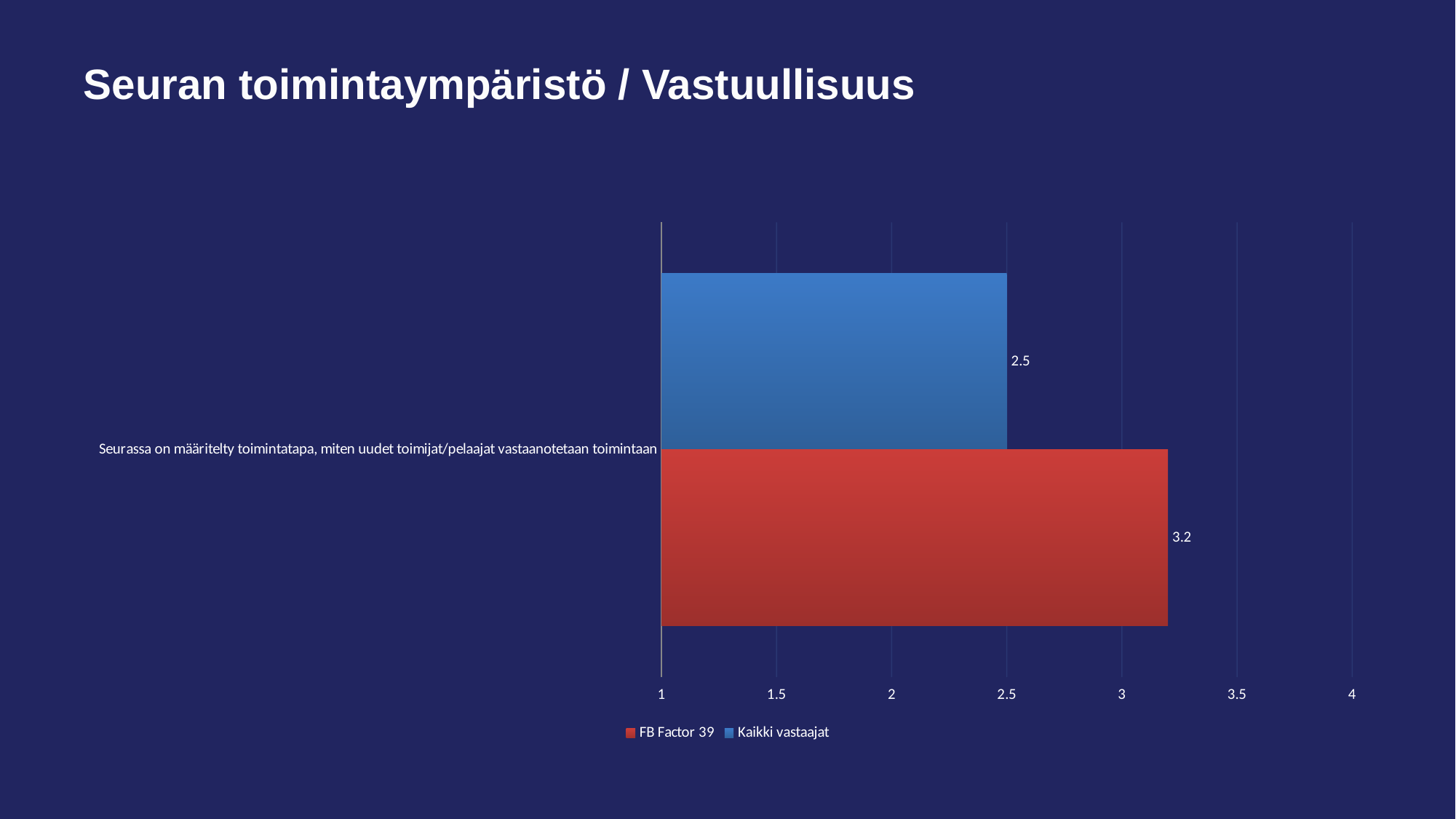
Is the value for Kaikki vastaajat greater or less than 3? less What is the difference between the FB Factor 39 value and the Kaikki vastaajat value? 0.7 What colour is the bar for FB Factor 39? Red What is the value for FB Factor 39 for the statement "Seurassa on määritelty toimintatapa, miten uudet toimijat/pelaajat vastaanotetaan toimintaan"? 3.2 How many series does the legend list? 2 What is the value for Kaikki vastaajat for the statement "Seurassa on määritelty toimintatapa, miten uudet toimijat/pelaajat vastaanotetaan toimintaan"? 2.5 Which series has the higher value, FB Factor 39 or Kaikki vastaajat? FB Factor 39 Is the value for FB Factor 39 greater or less than 3? greater How many categories are shown on the chart? 1 What is the highest value shown on the x axis? 4 What kind of chart is shown on the slide? Bar chart What is the title of the slide? Seuran toimintaympäristö / Vastuullisuus